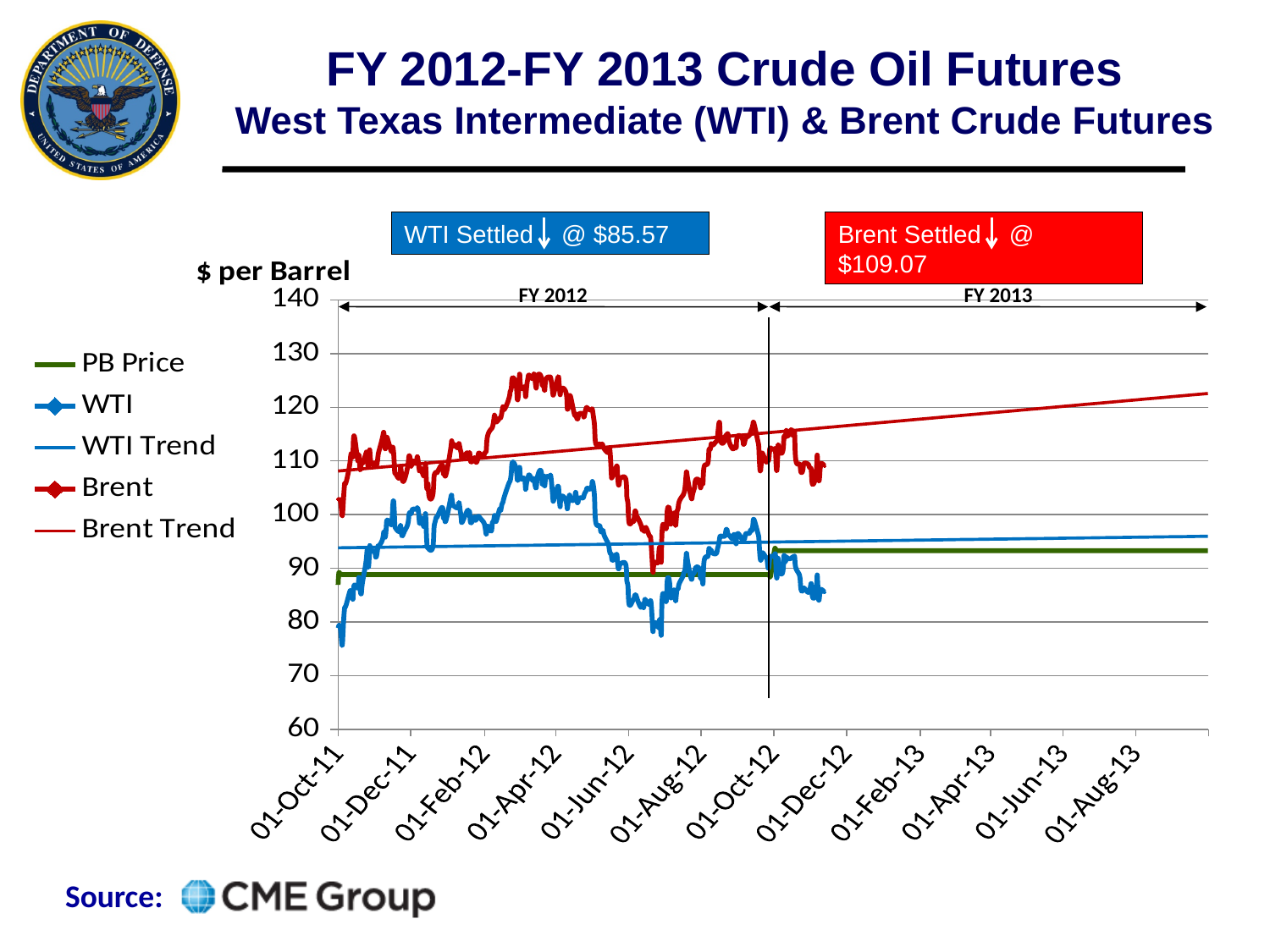
At what price did Brent settle, according to the callout on the chart? $109.07 Which settled at a higher price, WTI or Brent? Brent Is the PB Price line in FY 2013 greater or less than 90? greater Is the highest value reached by the Brent line greater or less than 120? greater What is the label on the vertical axis of the chart? $ per Barrel What source is cited for the chart data? CME Group Does the Brent Trend line rise or fall from left to right along the x axis? rises How many series does the chart legend list? 5 Is the lowest value reached by the WTI line greater or less than 80? less What kind of chart is shown on the slide? line chart At what price did WTI settle, according to the callout on the chart? $85.57 What is the difference between the Brent settled price and the WTI settled price? $23.50